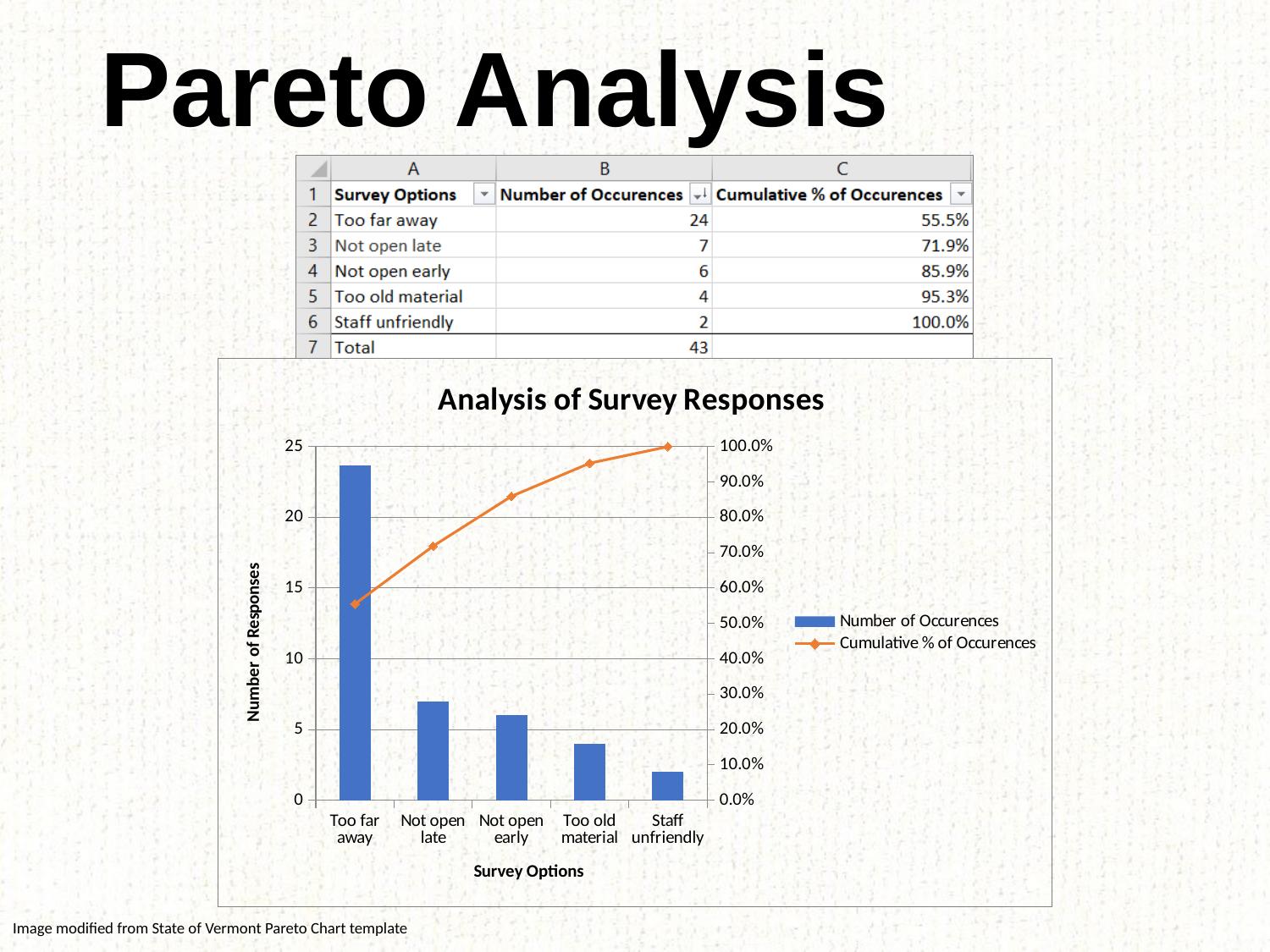
What kind of chart is 'Analysis of Survey Responses'? A combined bar and line chart How many survey options are shown on the x axis of the chart? 5 What is the cumulative % of occurrences at 'Not open early'? 85.9% Which has more occurrences, 'Not open early' or 'Too old material'? Not open early What is the title of the chart? Analysis of Survey Responses Which survey option has the highest number of occurrences? Too far away What is the number of occurrences for 'Too far away'? 24 Which survey option has the lowest number of occurrences? Staff unfriendly What is the difference in number of occurrences between 'Too far away' and 'Not open late'? 17 Do the bars for number of occurrences rise or fall from left to right along the x axis? fall How many series does the chart legend list? 2 Is the number of occurrences for 'Too far away' greater or less than 20? greater